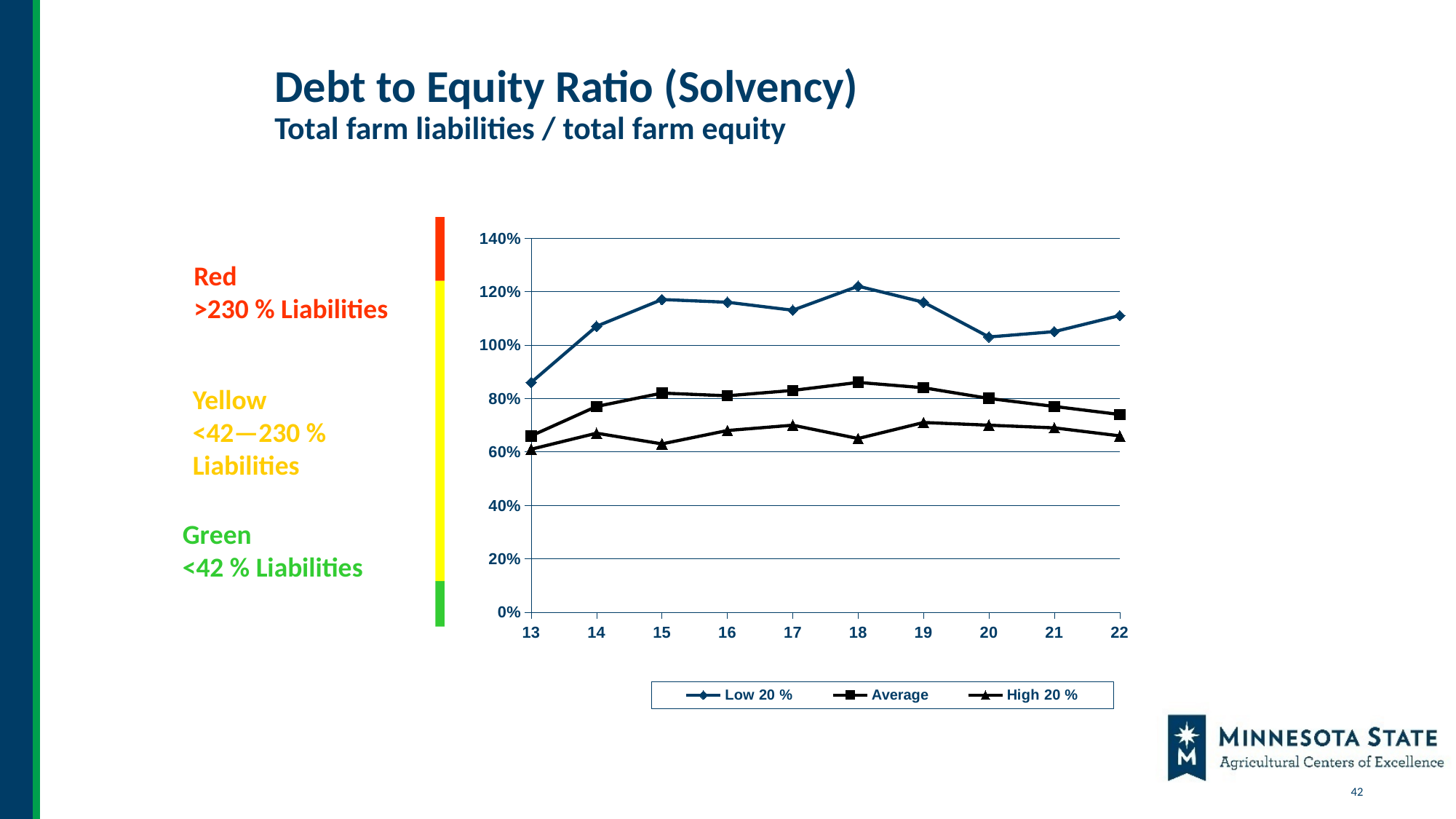
Is the value for Average in year 22 greater or less than 80%? less How many years are plotted along the x axis of the chart? 10 Is the value for Low 20 % in year 18 greater or less than 100%? greater In which year does the Low 20 % series reach its highest value? 18 Is the value for High 20 % in year 15 greater or less than 80%? less What kind of chart is shown on the slide? line chart What is the title of the slide containing the chart? Debt to Equity Ratio (Solvency) Which series has the higher value in year 18, Low 20 % or High 20 %? Low 20 % Does the Low 20 % series rise or fall from year 13 to year 15? rise How many series does the chart legend list? 3 In which year is the Low 20 % series at its lowest value? 13 In which year is the Average series at its lowest value? 13